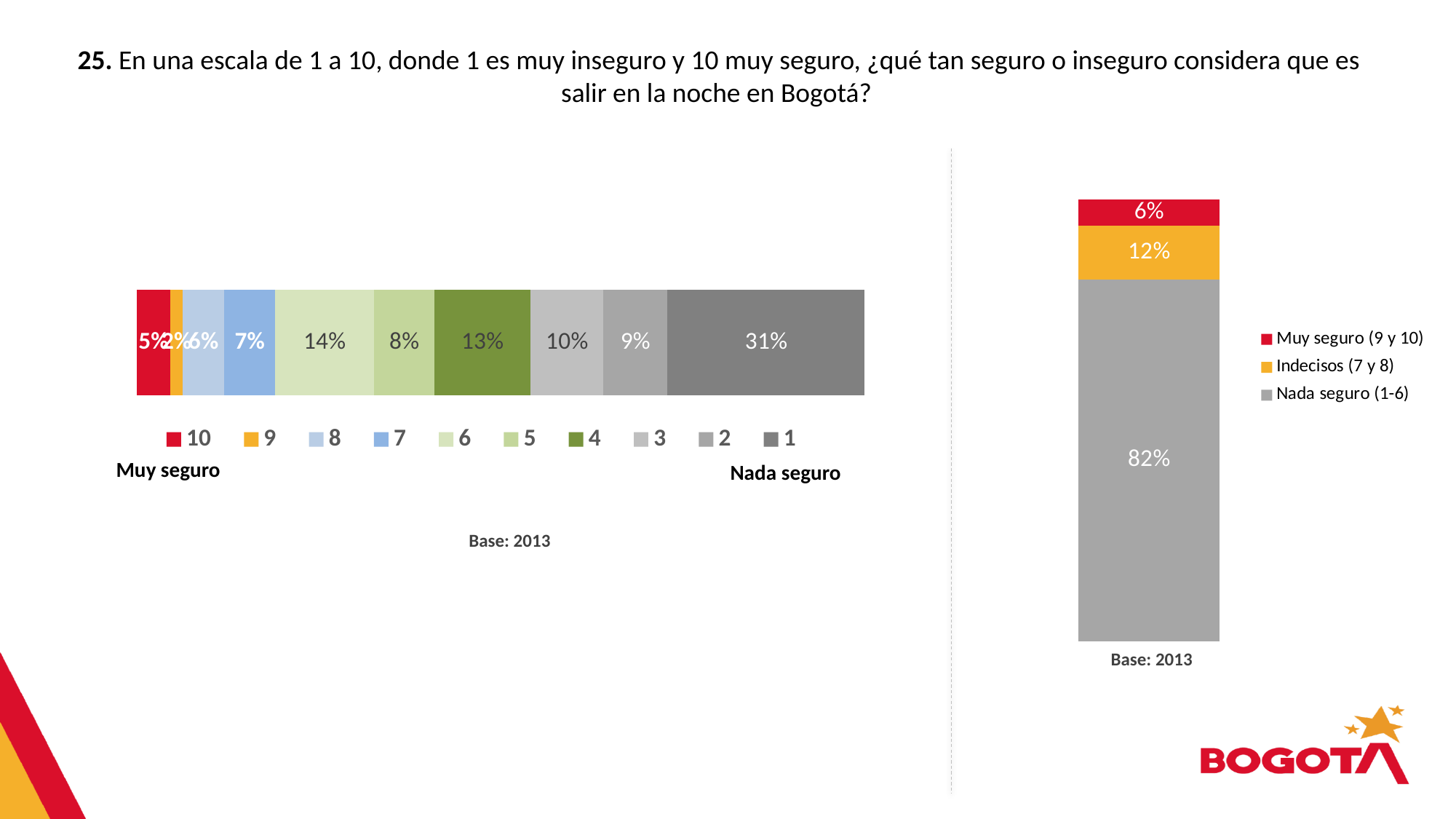
In the right chart, which category has the smallest share? Muy seguro (9 y 10) How many series does the legend of the left chart list? 10 In the right chart, what percentage corresponds to 'Indecisos (7 y 8)'? 12% In the left chart, what percentage of respondents gave a rating of 6? 14% In the left chart, what percentage of respondents gave a rating of 4? 13% In the left chart, which rating has the largest share of respondents? 1 In the left chart, what percentage of respondents gave a rating of 1? 31% In the left chart, which is larger: the share for rating 3 or the share for rating 2? rating 3 In the left chart, what percentage of respondents gave a rating of 7? 7% In the right chart, what percentage corresponds to 'Nada seguro (1-6)'? 82% In the left chart, what is the difference between the share for rating 1 and the share for rating 6? 17% What type of chart is the right chart? Stacked bar chart